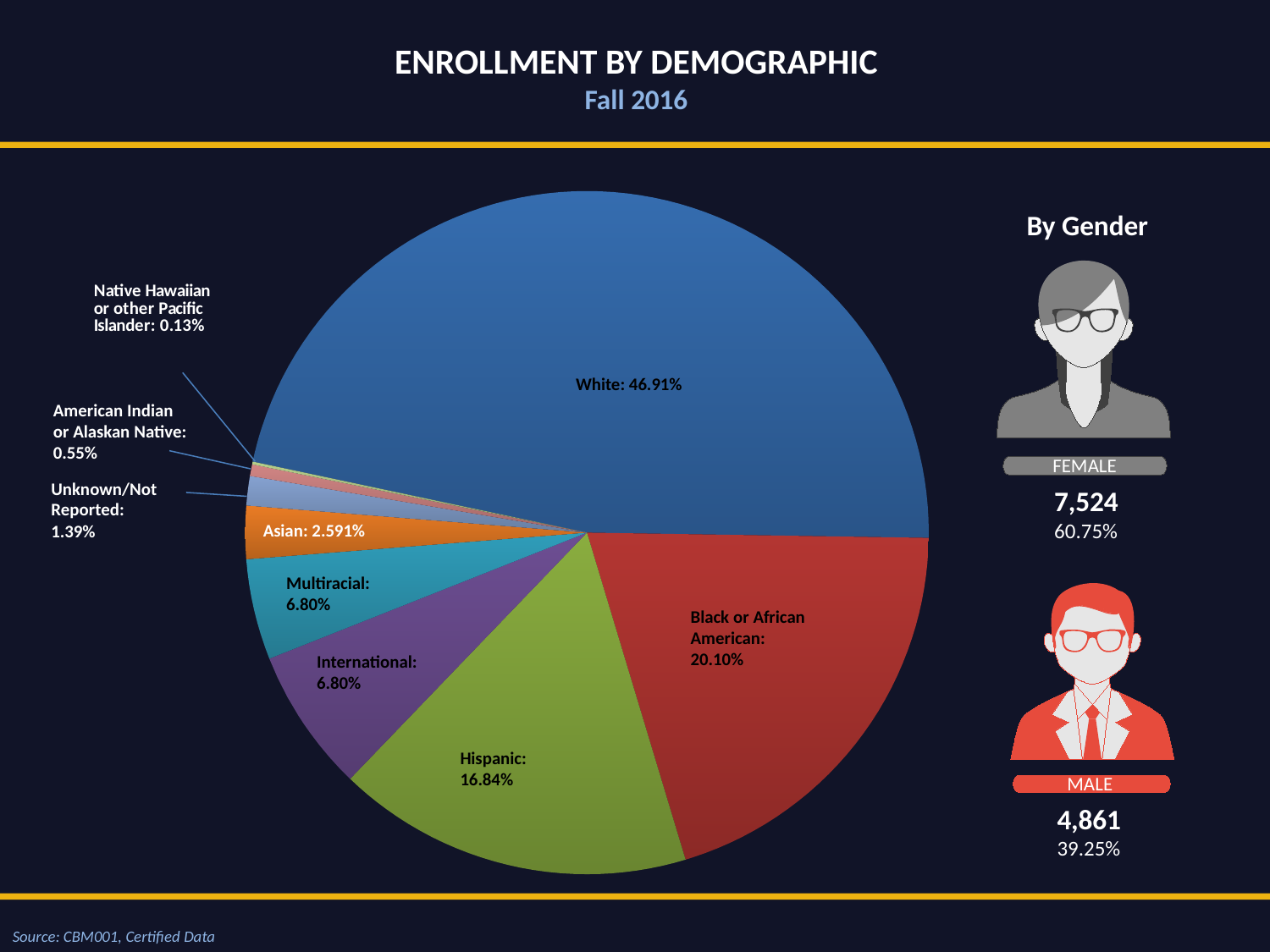
What type of chart is shown on the slide? pie chart What share of enrollment is Asian? 2.591% Which is larger, the Hispanic share or the Black or African American share? Black or African American What is the subtitle of the chart slide? Fall 2016 What is the difference in percentage points between the White and Black or African American shares? 26.81 Which demographic group has the smallest share of enrollment? Native Hawaiian or other Pacific Islander Which demographic group has the largest share of enrollment? White How many demographic categories are shown in the pie chart? 9 What share of enrollment is Unknown/Not Reported? 1.39% What share of enrollment is Hispanic? 16.84% What share of enrollment is White? 46.91% What share of enrollment is Black or African American? 20.10%